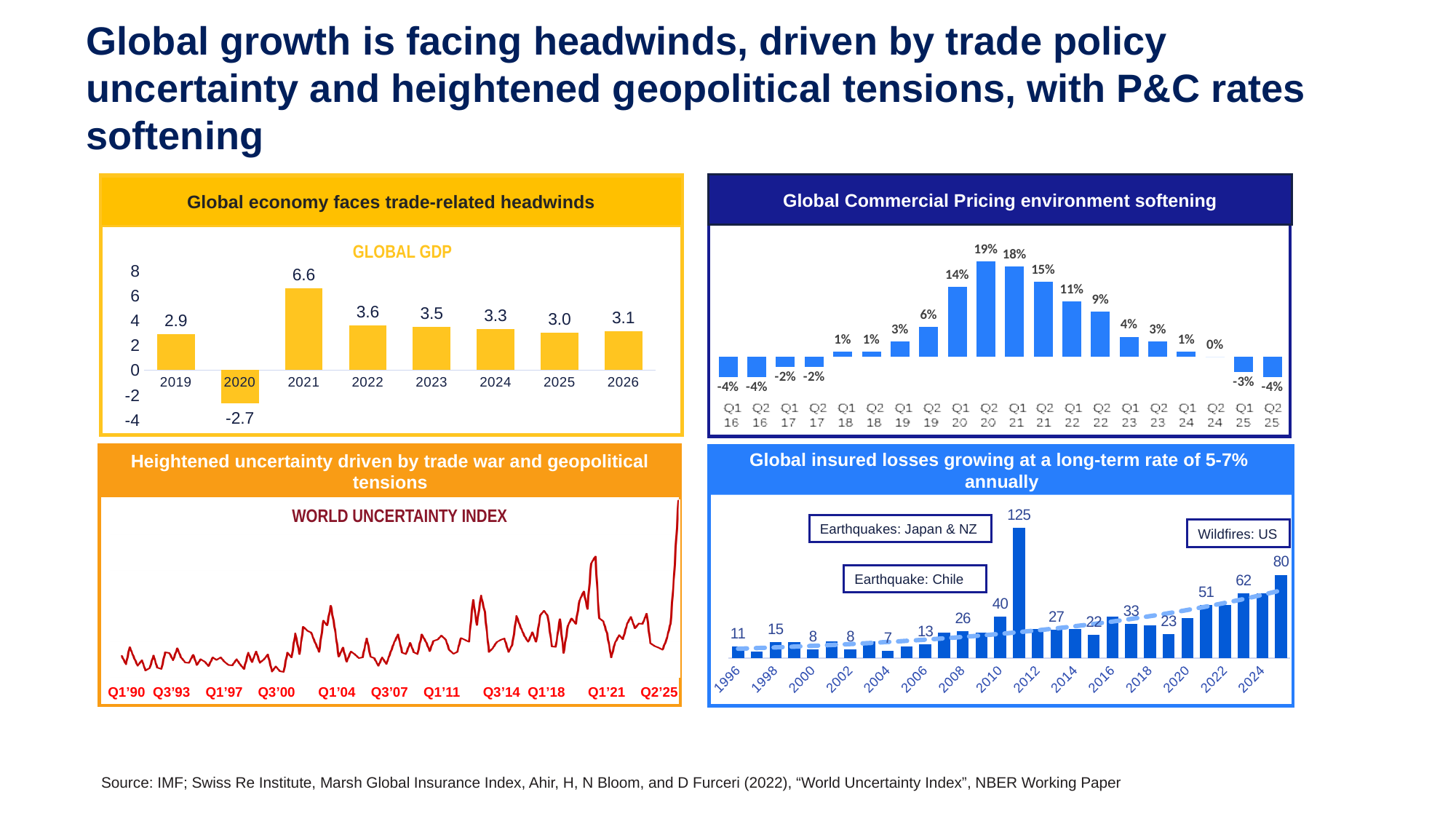
In the Global Commercial Pricing chart, what is the value for Q2 25? -4% In the Global Commercial Pricing chart, which quarter has the highest value? Q2 20 How many years are shown in the Global GDP chart? 8 In the Global GDP chart, what is the difference between the 2022 value and the 2025 value? 0.6 In the Global insured losses chart, what is the highest value shown? 125 What kind of chart is the World Uncertainty Index chart? Line chart In the Global Commercial Pricing chart, what is the value for Q2 20? 19% In the Global GDP chart, which year has the lowest value? 2020 In the Global GDP chart, what is the value for 2020? -2.7 In the Global GDP chart, what is the value for 2021? 6.6 In the Global GDP chart, which year has the highest value? 2021 In the Global Commercial Pricing chart, which is larger, the value for Q1 22 or the value for Q2 22? Q1 22